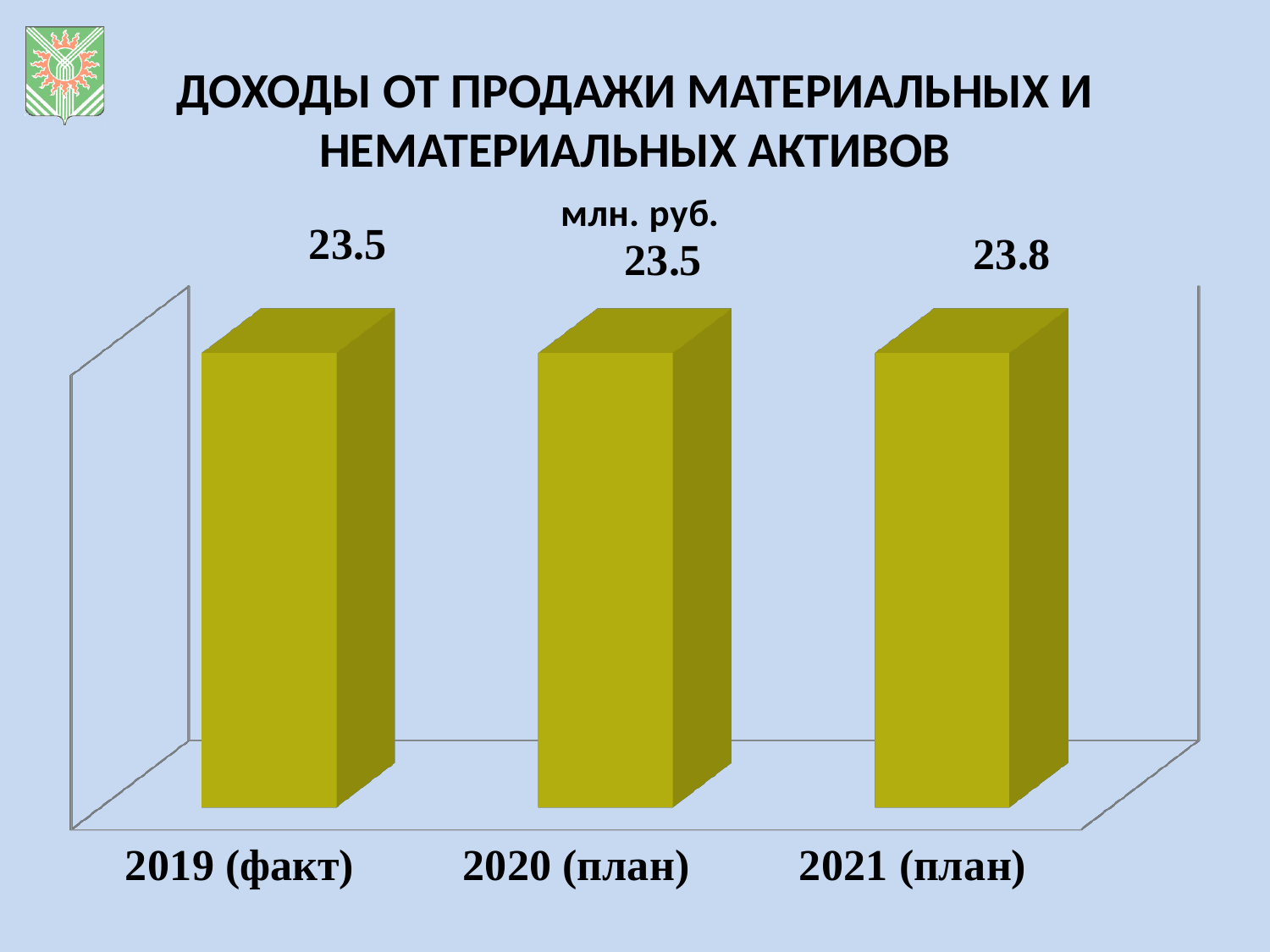
Which category has the highest value? 2021 (план) What is the value for 2019 (факт)? 23.5 What is the difference between the values for 2021 (план) and 2019 (факт)? 0.3 Are the values for 2019 (факт) and 2020 (план) equal? Yes What unit of measurement is shown on the chart? млн. руб. Which is larger, the value for 2021 (план) or the value for 2020 (план)? 2021 (план) What is the value for 2020 (план)? 23.5 What kind of chart is shown on the slide? Bar chart How many categories are shown on the chart? 3 Do the values rise or fall from 2019 (факт) to 2021 (план)? Rise What is the title of the chart? ДОХОДЫ ОТ ПРОДАЖИ МАТЕРИАЛЬНЫХ И НЕМАТЕРИАЛЬНЫХ АКТИВОВ What is the value for 2021 (план)? 23.8